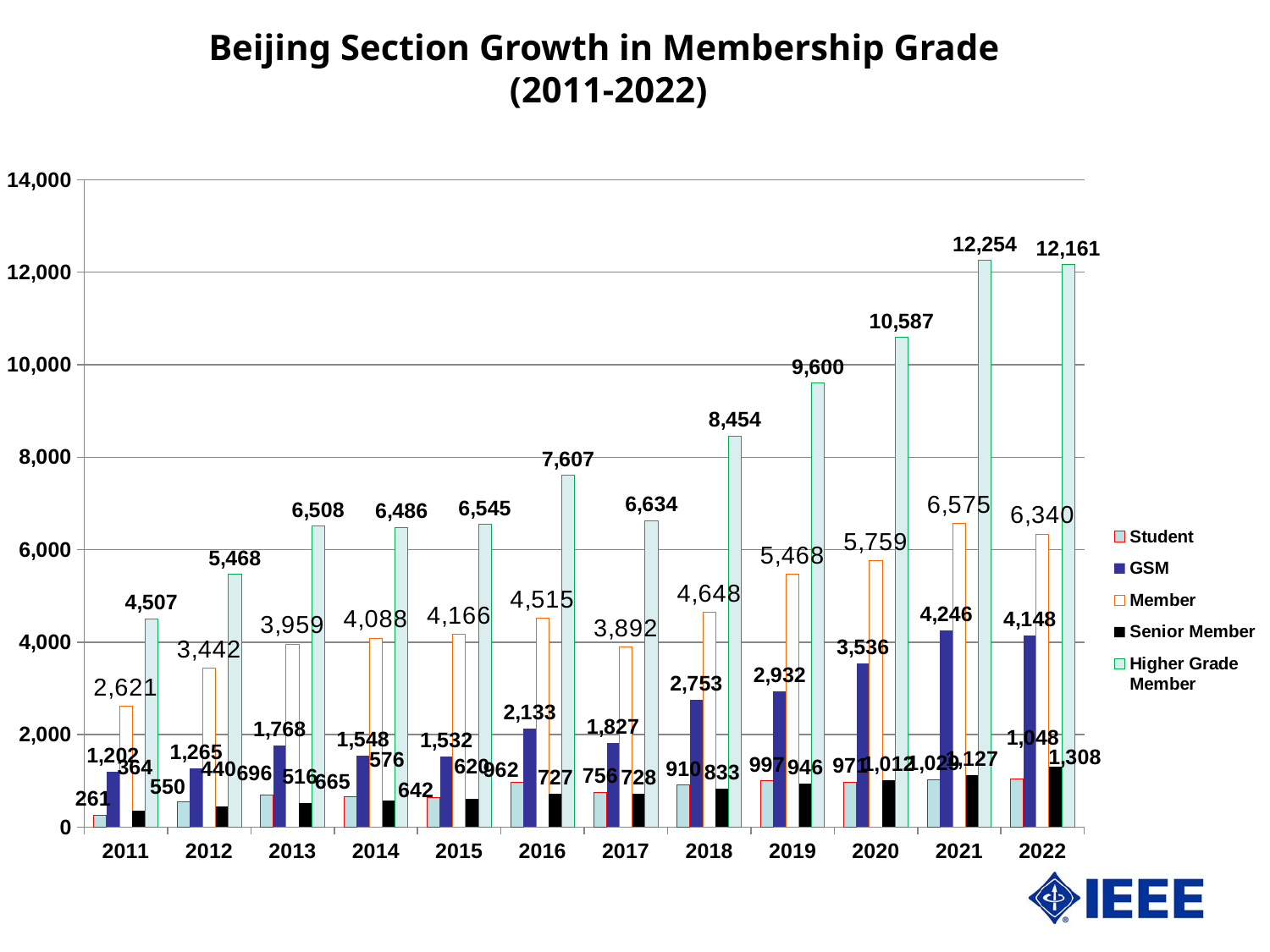
What is the title of the chart? Beijing Section Growth in Membership Grade (2011-2022) What is the difference between the Higher Grade Member values for 2021 and 2020? 1,667 Is the GSM value for 2018 greater or less than 2,000? greater What is the Member value for 2019? 5,468 In which year is the Higher Grade Member value lowest? 2011 How many years are shown on the x axis? 12 What is the Higher Grade Member value for 2022? 12,161 What is the GSM value for 2016? 2,133 Which year has the larger GSM value, 2021 or 2022? 2021 How many series does the legend list? 5 What kind of chart is shown on the slide? bar chart In which year is the Higher Grade Member value highest? 2021